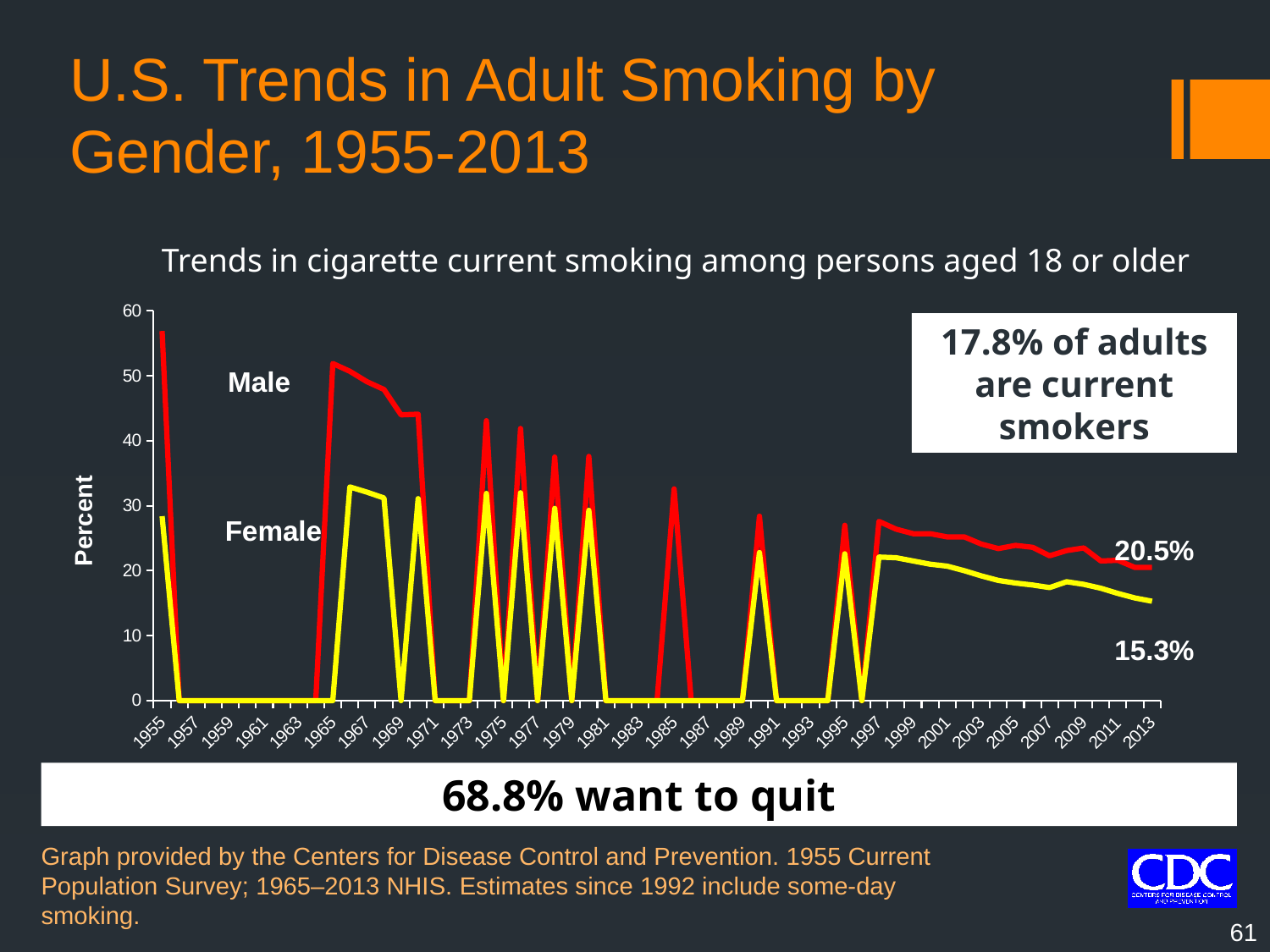
In 2013, which is larger, the Male value or the Female value? Male What colour is the Male line? red What kind of chart is shown on the slide? line chart What is the Female smoking percentage in 2013? 15.3% Do the Male values rise or fall from 1997 to 2013? fall What is the Male smoking percentage in 2013? 20.5% In which year does the Male line reach its highest value? 1955 Is the Female value for 1965 greater or less than 40? less Is the Male value for 1955 greater or less than 50? greater What is the difference between the Male and Female values in 2013? 5.2% How many series are plotted on the chart? 2 What is the title of the y axis? Percent